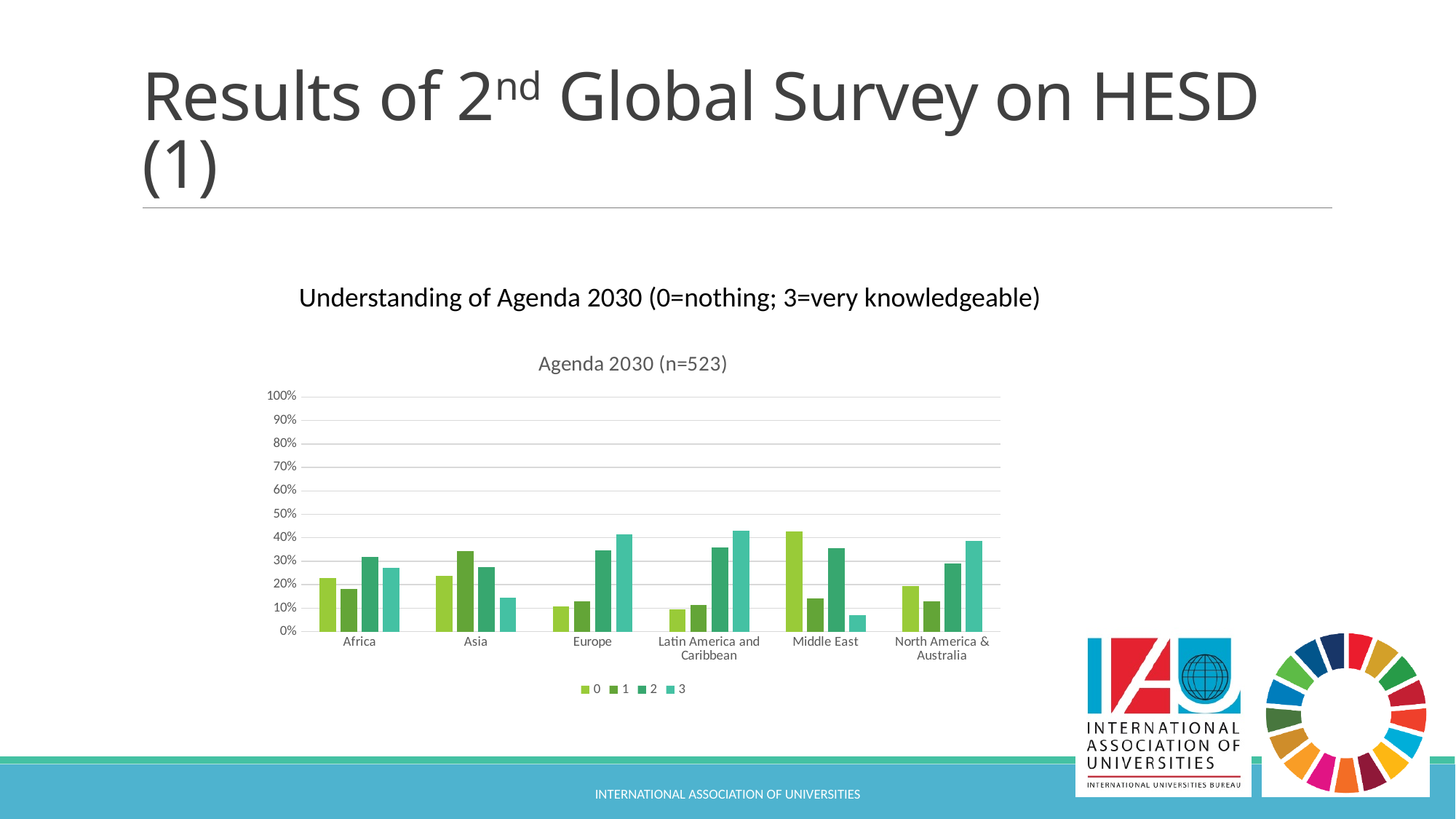
What is the title printed above the chart's plot area? Agenda 2030 (n=523) Is the value for series 0 in Middle East greater or less than 30%? greater Is the value for series 3 in Europe greater or less than 30%? greater For Africa, which is larger: the value for series 1 or the value for series 2? series 2 Is the value for series 3 in Asia greater or less than 20%? less How many regions are shown on the x axis of the chart? 6 Which region has the highest value for series 0? Middle East What are the entries listed in the chart's legend? 0, 1, 2, 3 What kind of chart is shown on the slide? bar chart Which region has the highest value for series 1? Asia Which region has the lowest value for series 3? Middle East How many series does the legend of the chart list? 4